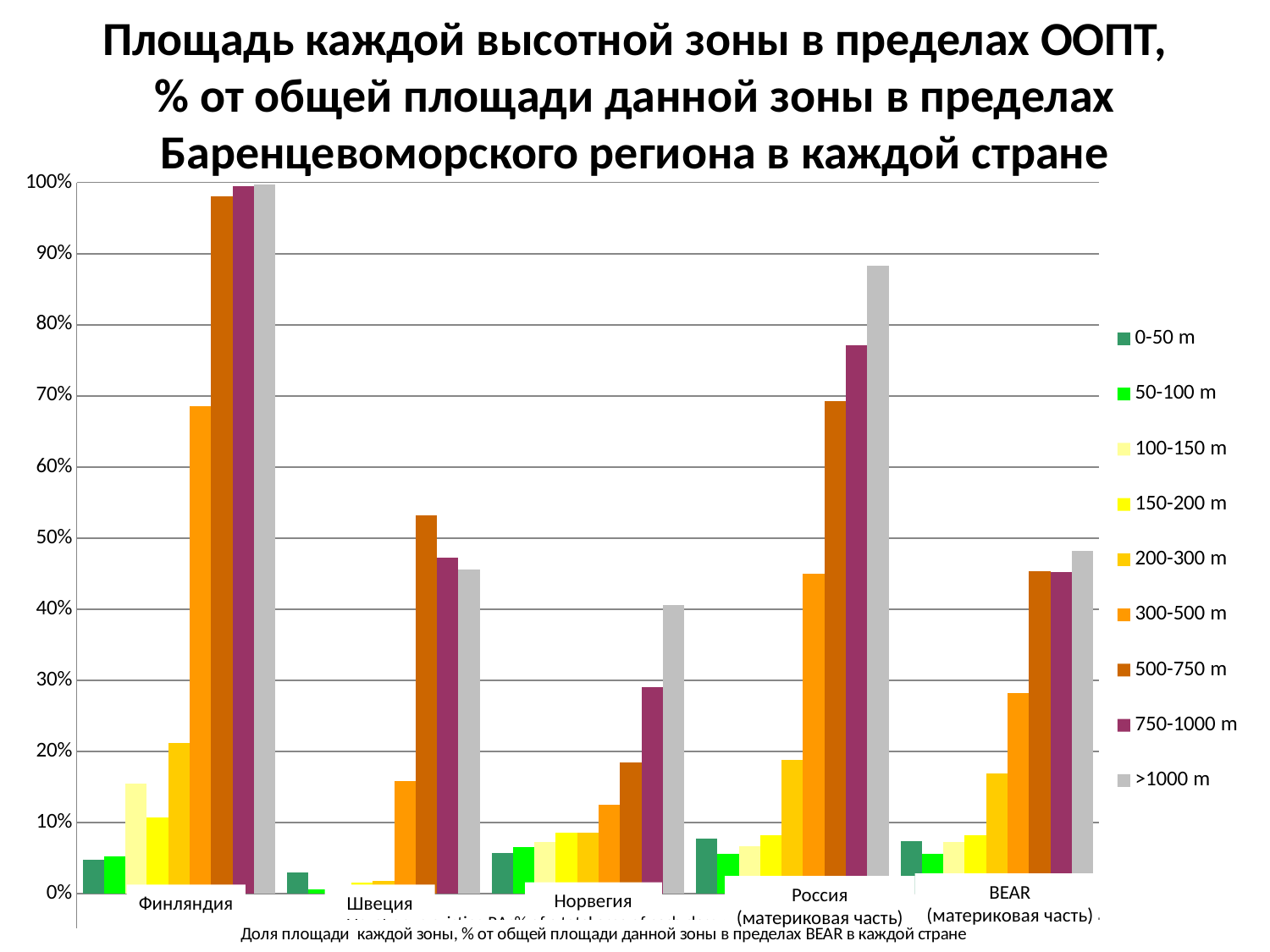
Is the value for 500-750 m in Швеция greater or less than 50%? greater Is the value for >1000 m in Норвегия greater or less than 50%? less Which country/region has the highest value for >1000 m? Финляндия What kind of chart is shown on the slide? bar chart How many series does the legend list? 9 Is the value for >1000 m in Россия (материковая часть) greater or less than 80%? greater Which has the larger value for 300-500 m, Финляндия or Россия (материковая часть)? Финляндия Which has the larger value for 750-1000 m, Швеция or Норвегия? Швеция Which country/region has the lowest value for 500-750 m? Норвегия How many countries/regions are shown along the x axis? 5